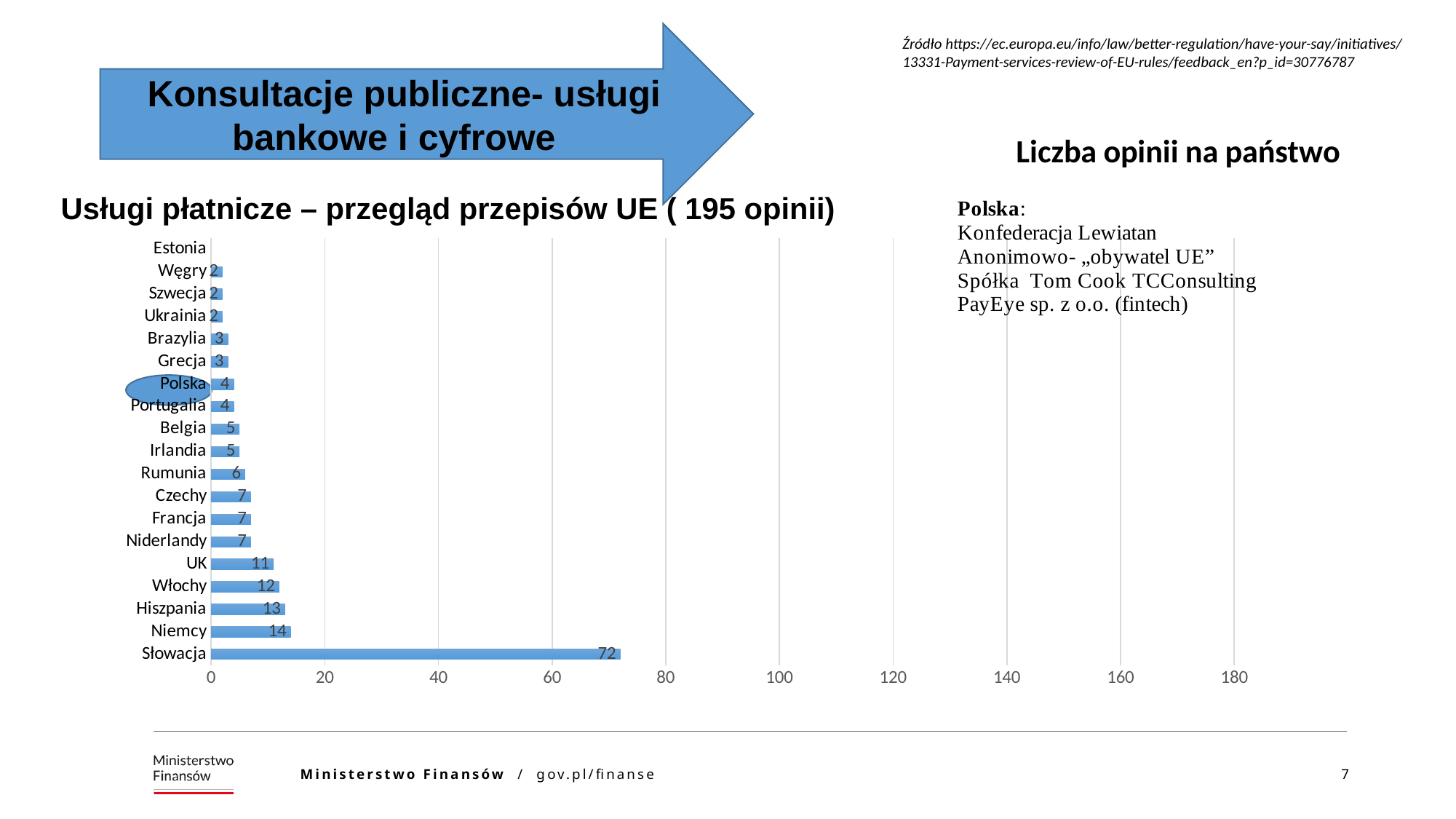
How many countries are listed on the chart's axis? 19 What is the value for Niemcy? 14 What kind of chart is shown on the slide? bar chart What is the title of the chart? Liczba opinii na państwo Which has a larger value, Hiszpania or Włochy? Hiszpania What is the difference between the values for Hiszpania and Polska? 9 Which country has the highest value in the chart? Słowacja What is the difference between the values for Słowacja and Niemcy? 58 What is the value for Słowacja? 72 What is the value for UK? 11 What is the value for Polska? 4 Is the value for Słowacja greater or less than 60? greater